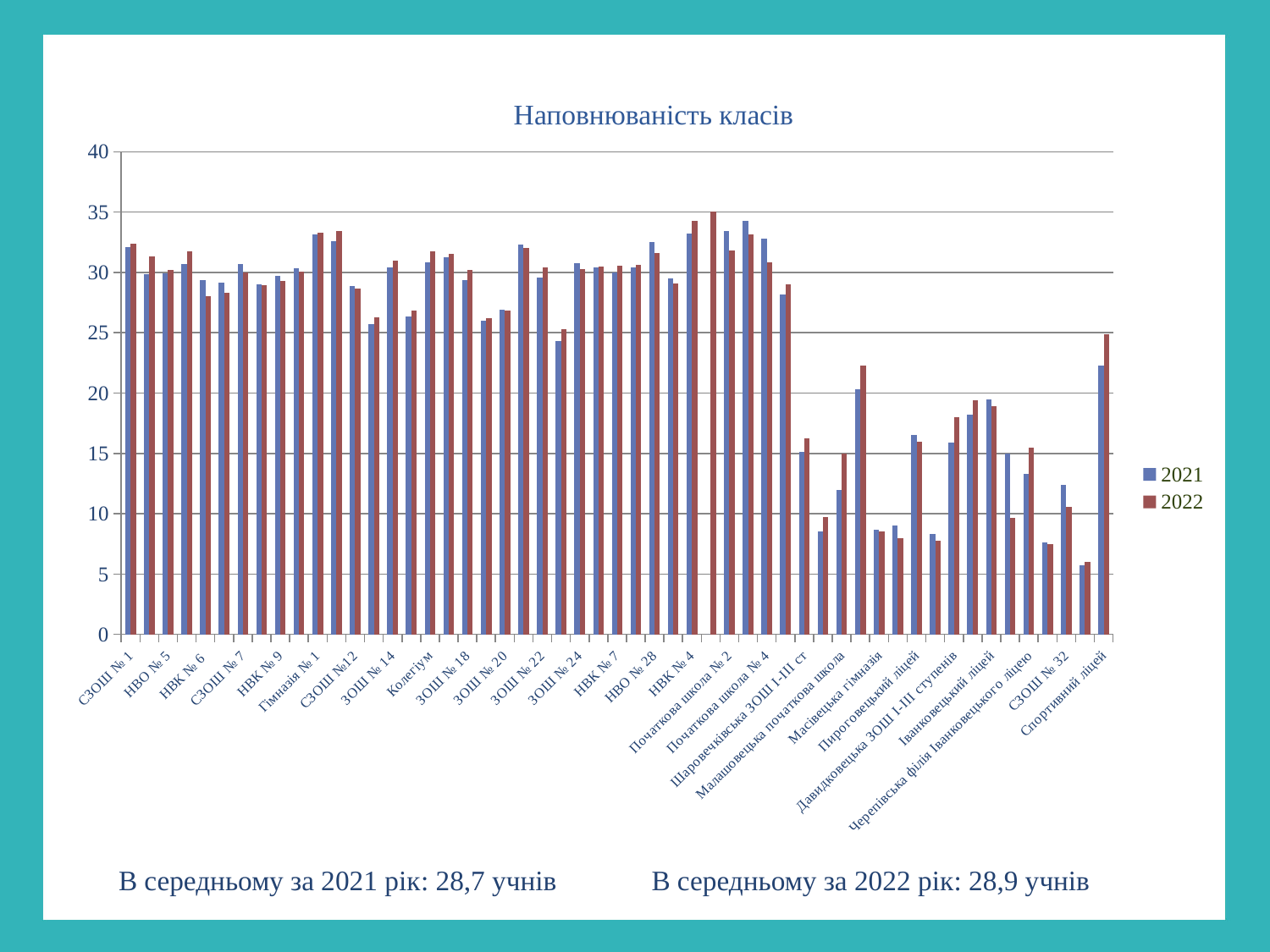
For Спортивний ліцей, which series has the larger value, 2021 or 2022? 2022 For Малашовецька початкова школа, which series has the larger value, 2021 or 2022? 2022 Is the 2021 value for СЗОШ № 32 greater or less than 10? greater Is the 2021 value for Спортивний ліцей greater or less than 25? less Is the 2022 value for Спортивний ліцей greater or less than 20? greater For Черепівська філія Іванковецького ліцею, which series has the larger value, 2021 or 2022? 2022 What are the two series named in the legend? 2021 and 2022 How many series does the legend list? 2 What kind of chart is shown on the slide? bar chart What is the title of the chart? Наповнюваність класів